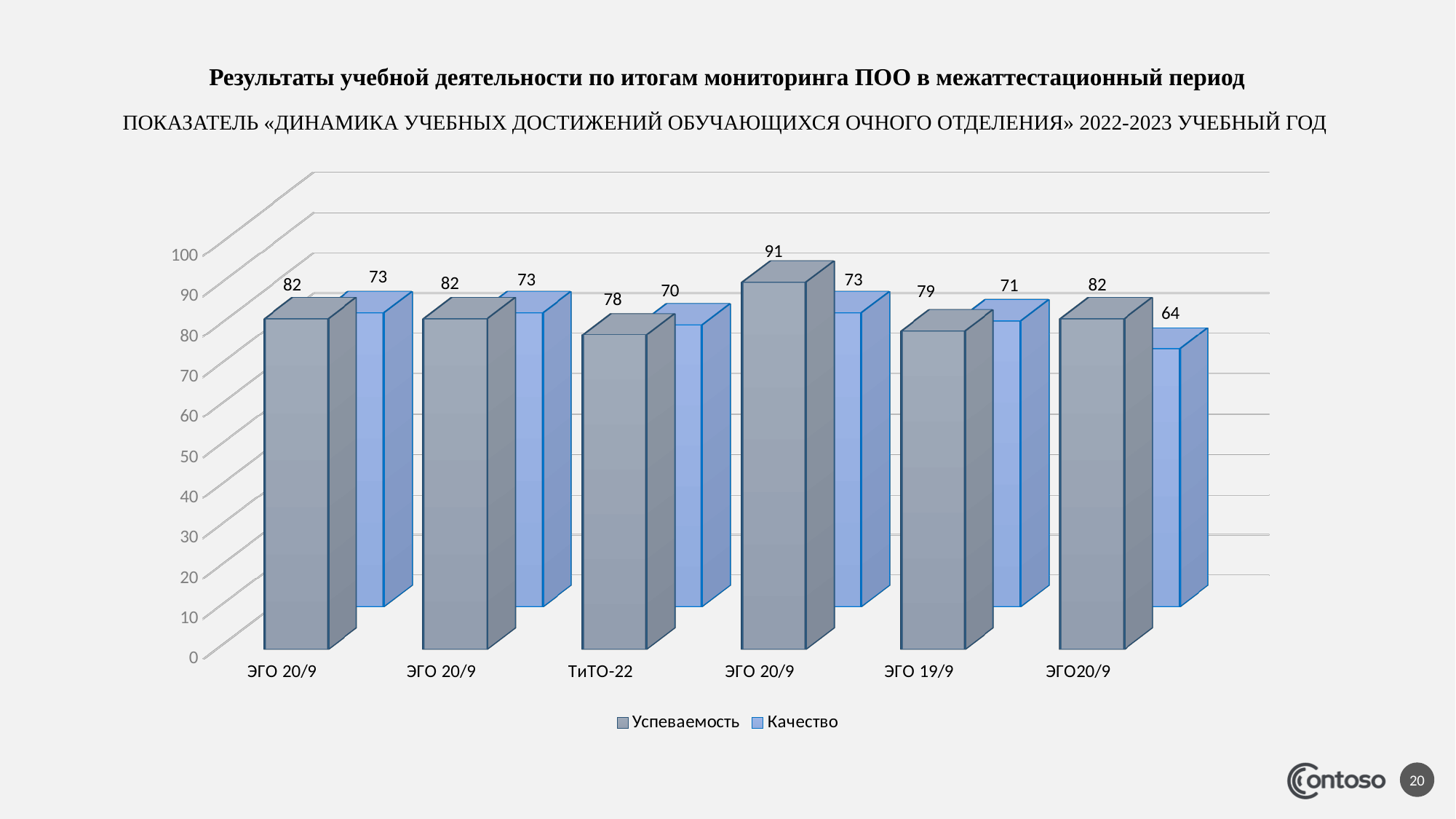
Which category has the highest Успеваемость value? the fourth category from the left (ЭГО 20/9), 91 What are the two series named in the legend? Успеваемость and Качество What is the Качество value for ЭГО 19/9? 71 What is the Качество value for the rightmost category (ЭГО20/9)? 64 What is the difference between the Успеваемость and Качество values for ТиТО-22? 8 What is the Успеваемость value for the fourth category from the left? 91 How many categories are shown on the x axis? 6 What kind of chart is shown on the slide? bar chart What is the Успеваемость value for ТиТО-22? 78 Which category has the lowest Качество value? ЭГО20/9 (rightmost), 64 How many series does the legend list? 2 Which is larger for ЭГО 19/9: Успеваемость or Качество? Успеваемость